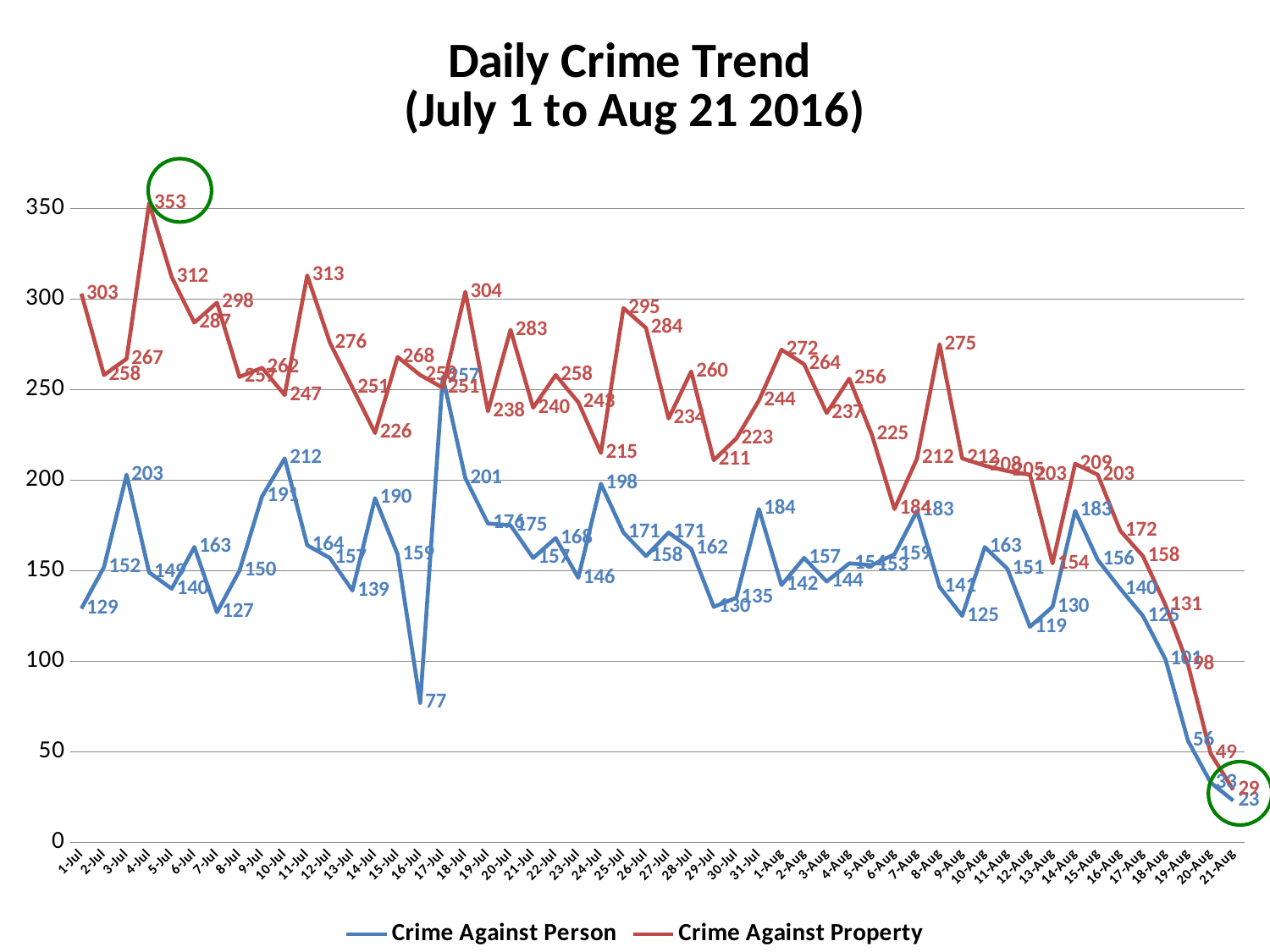
What is the value for Crime Against Property on 4-Jul? 353 What kind of chart is shown on the slide? line chart What is the value for Crime Against Person on 16-Jul? 77 On which date does Crime Against Person reach its lowest value? 21-Aug What is the difference between Crime Against Property and Crime Against Person on 1-Jul? 174 Is the value for Crime Against Person on 10-Jul greater or less than 200? greater Which series has the higher value on 4-Jul, Crime Against Person or Crime Against Property? Crime Against Property What is the value for Crime Against Property on 1-Jul? 303 On which date does Crime Against Property reach its highest value? 4-Jul Do the values for Crime Against Property rise or fall from 14-Aug to 21-Aug? fall How many series does the legend list? 2 What is the value for Crime Against Person on 21-Aug? 23